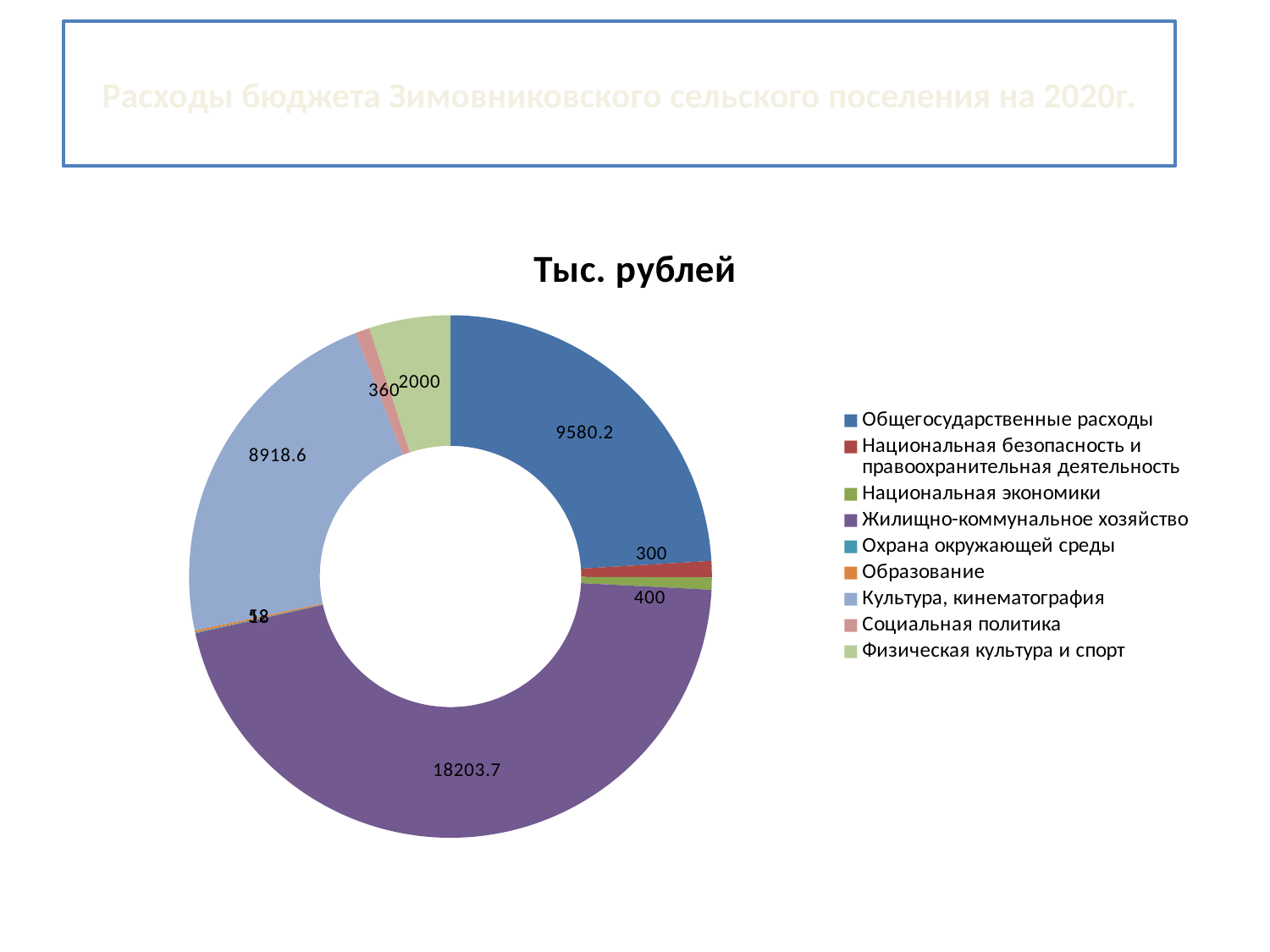
What is the value for Социальная политика? 360 Which category has the largest slice? Жилищно-коммунальное хозяйство What is the value for Жилищно-коммунальное хозяйство? 18203.7 What is the value for Общегосударственные расходы? 9580.2 What is the value for Физическая культура и спорт? 2000 What is the value for Национальная экономики? 300 What is the value for Культура, кинематография? 8918.6 How many categories does the legend list? 9 What is the difference between the values for Жилищно-коммунальное хозяйство and Общегосударственные расходы? 8623.5 What kind of chart is shown on the slide? doughnut chart Which is larger: Общегосударственные расходы or Культура, кинематография? Общегосударственные расходы What is the title of the chart? Тыс. рублей